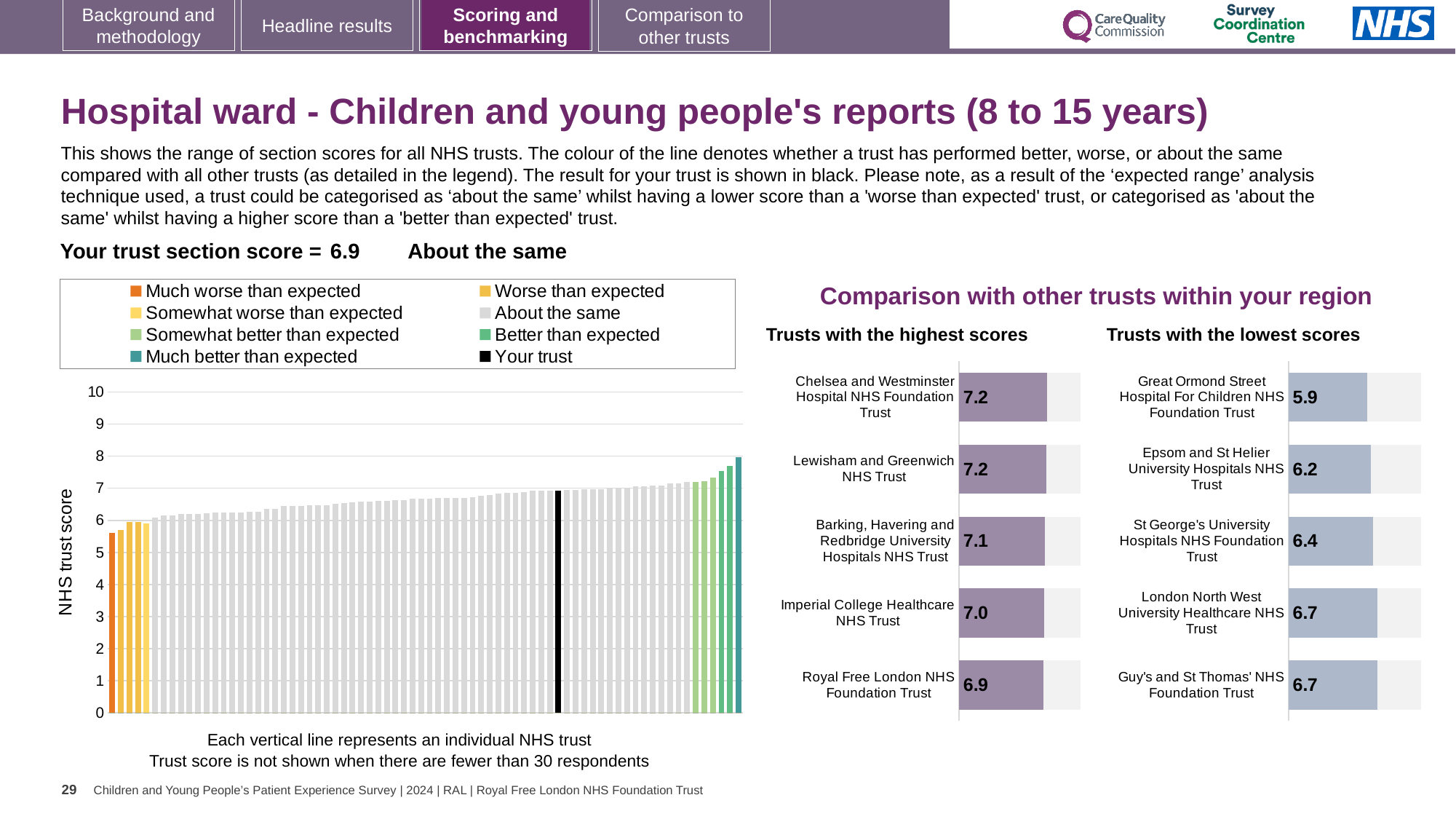
In the large 'NHS trust score' chart on the left, do the bar values rise or fall from left to right? rise How many entries does the legend above the large 'NHS trust score' chart list? 8 How many trusts are listed in the 'Trusts with the lowest scores' chart? 5 In the 'Trusts with the highest scores' chart, what is the score for Chelsea and Westminster Hospital NHS Foundation Trust? 7.2 In the 'Trusts with the highest scores' chart, what is the difference between the score for Chelsea and Westminster Hospital NHS Foundation Trust and the score for Royal Free London NHS Foundation Trust? 0.3 In the 'Trusts with the highest scores' chart, what is the score for Imperial College Healthcare NHS Trust? 7.0 In the 'Trusts with the highest scores' chart, which has the higher score: Barking, Havering and Redbridge University Hospitals NHS Trust or Imperial College Healthcare NHS Trust? Barking, Havering and Redbridge University Hospitals NHS Trust In the large 'NHS trust score' chart on the left, is the value of the black bar for your trust greater or less than 6? greater In the 'Trusts with the lowest scores' chart, what is the difference between the score for Guy's and St Thomas' NHS Foundation Trust and the score for Great Ormond Street Hospital For Children NHS Foundation Trust? 0.8 In the 'Trusts with the lowest scores' chart, what is the score for St George's University Hospitals NHS Foundation Trust? 6.4 In the 'Trusts with the lowest scores' chart, which trust has the lowest score? Great Ormond Street Hospital For Children NHS Foundation Trust In the 'Trusts with the lowest scores' chart, what is the score for Great Ormond Street Hospital For Children NHS Foundation Trust? 5.9